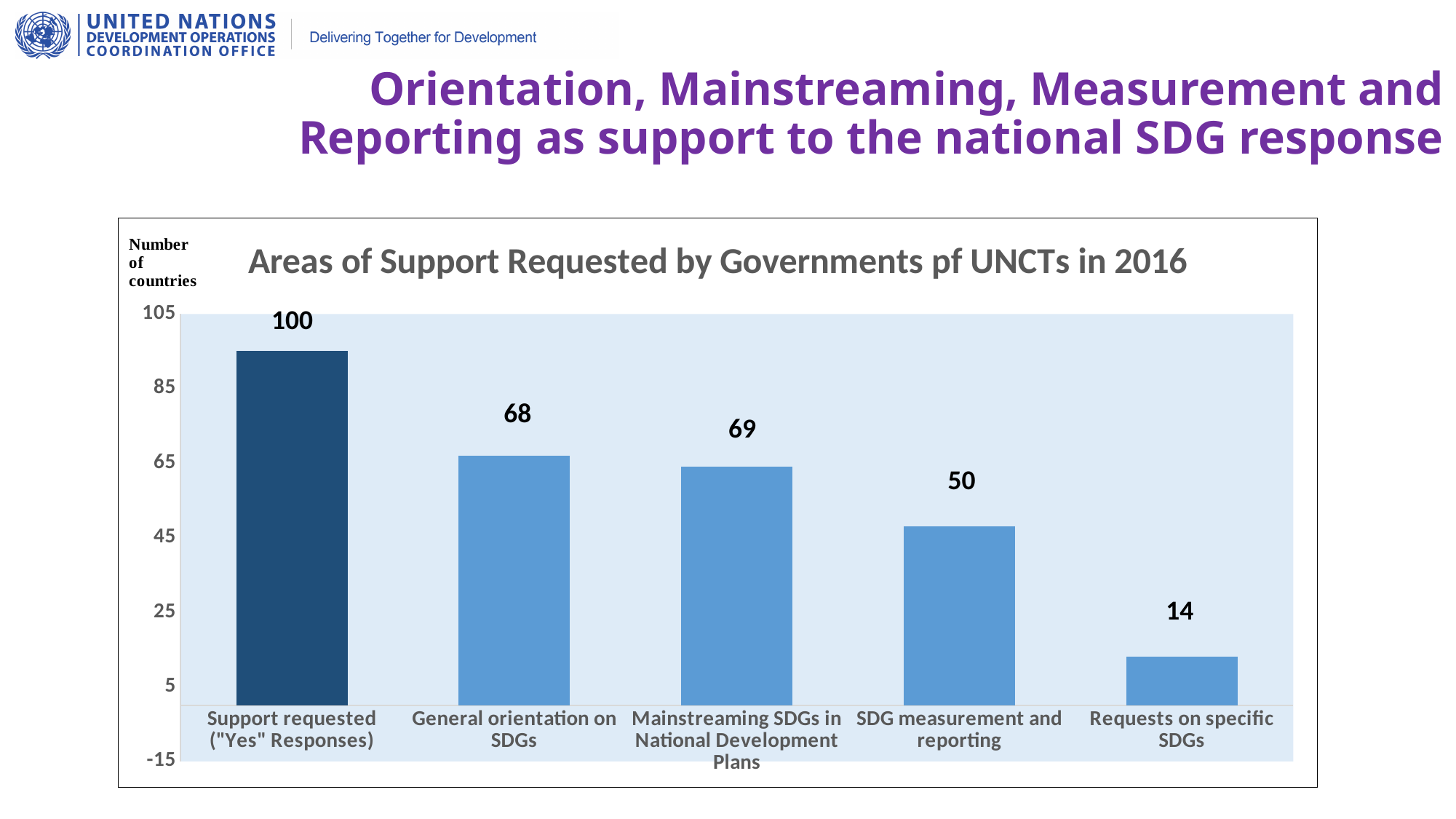
What is the title of the chart? Areas of Support Requested by Governments pf UNCTs in 2016 What kind of chart is shown on the slide? Bar chart What is the value for "Requests on specific SDGs"? 14 What is the value for "General orientation on SDGs"? 68 Which category has the highest value? Support requested ("Yes" Responses) Which category has the lowest value? Requests on specific SDGs What is the difference between the values for "SDG measurement and reporting" and "Requests on specific SDGs"? 36 What is the value for "Support requested ("Yes" Responses)"? 100 Which is larger: the value for "General orientation on SDGs" or the value for "SDG measurement and reporting"? General orientation on SDGs How many categories are shown in the chart? 5 What is the value for "Mainstreaming SDGs in National Development Plans"? 69 What is the value for "SDG measurement and reporting"? 50